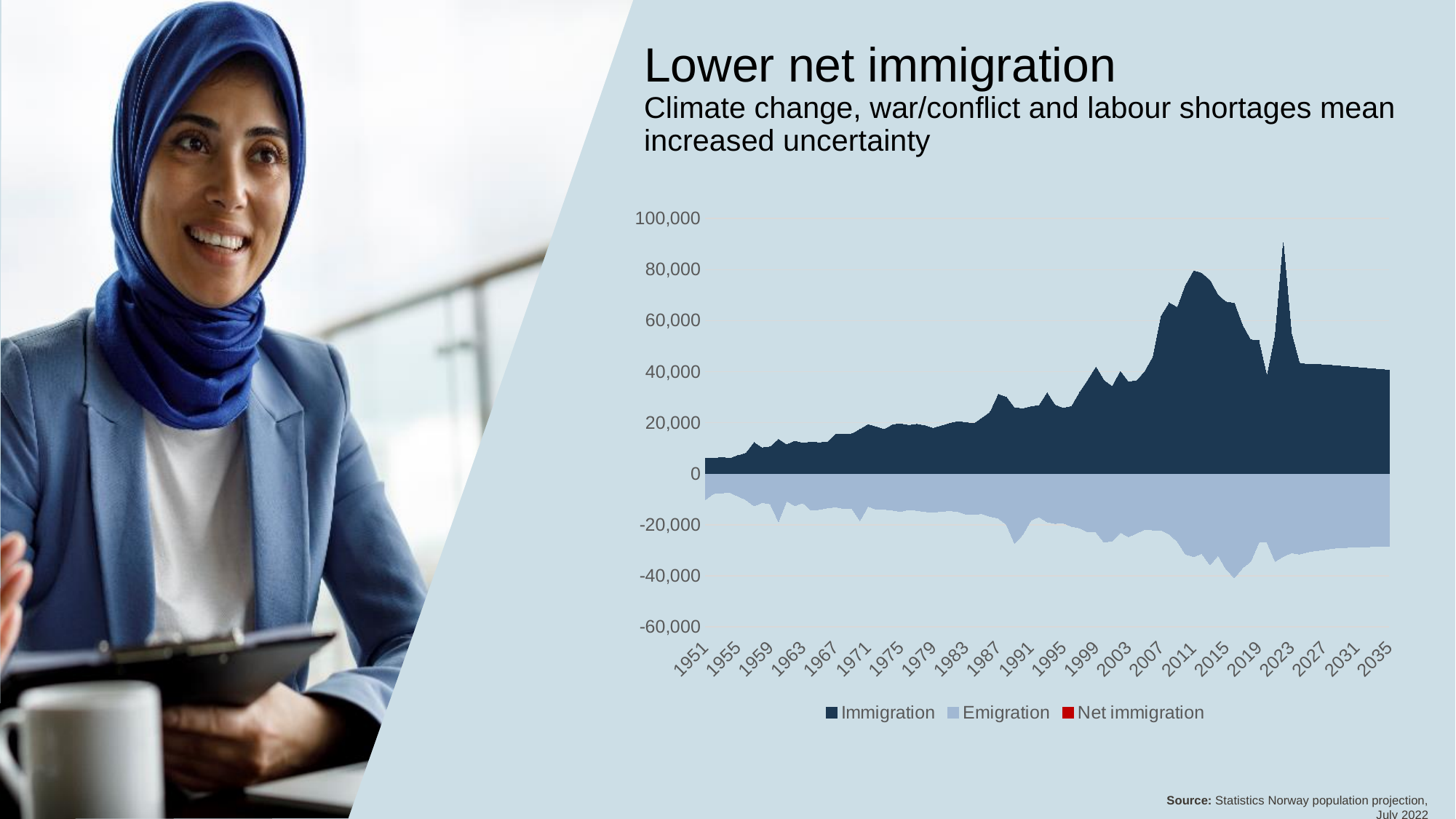
What is the first year shown on the x axis of the chart? 1951 Is the Immigration value for 2035 greater or less than 60,000? less What kind of chart is shown on the slide? Area chart Is the Immigration value for 2035 greater or less than 20,000? greater Which series are listed in the chart legend? Immigration, Emigration, Net immigration Does Immigration generally rise or fall from 1951 to 2011? rise Is the Emigration value for 1951 above or below -20,000 on the axis? above How many series does the chart legend list? 3 What is the title of the slide containing the chart? Lower net immigration